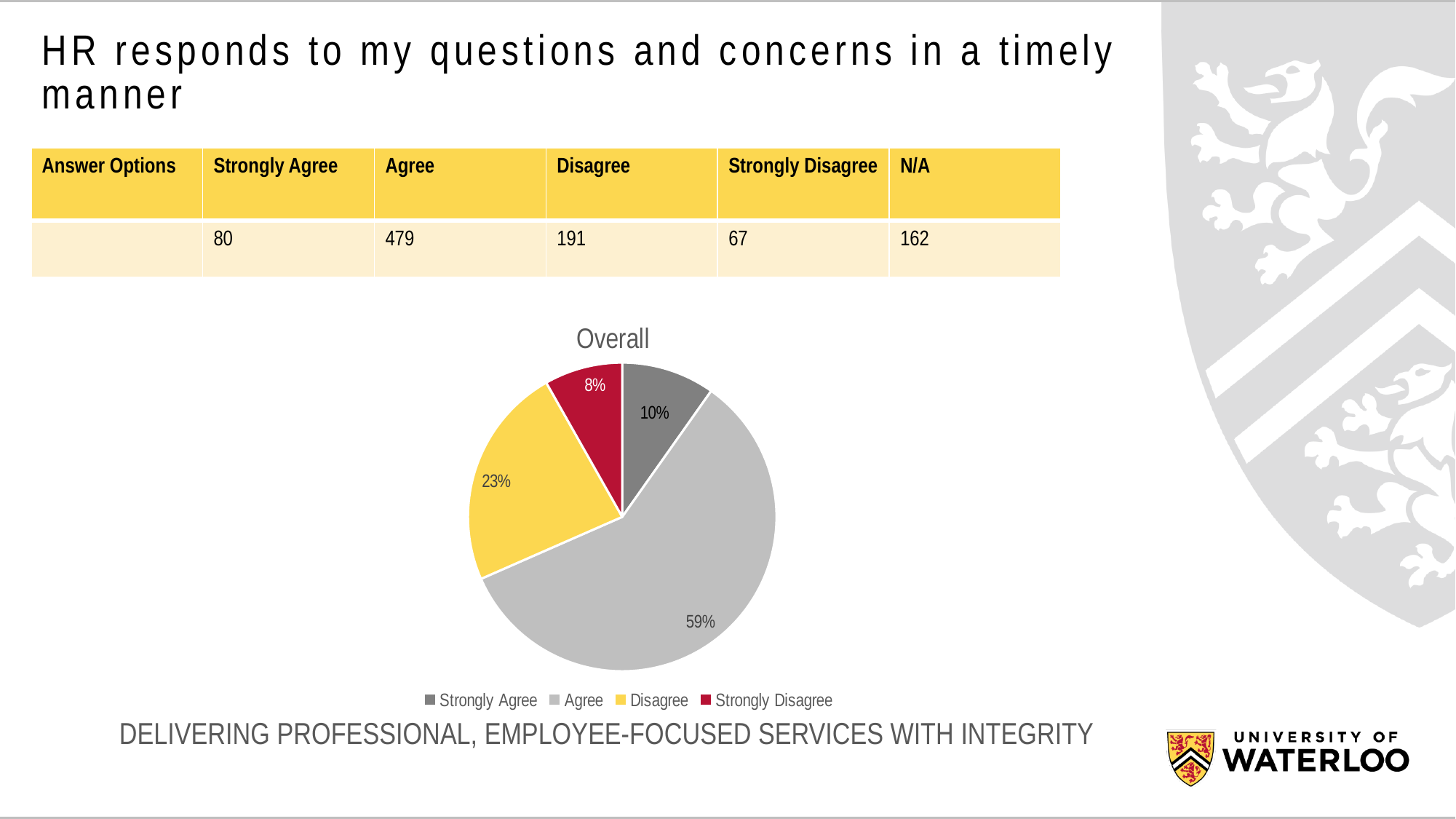
What colour is the Disagree slice in the pie chart? yellow How many categories does the pie chart legend list? 4 Which category has the largest slice of the pie? Agree What kind of chart is shown on the slide? pie chart What share of the pie does Strongly Agree represent? 10% What is the difference in percentage points between the Agree slice and the Disagree slice? 36 What share of the pie does Agree represent? 59% What share of the pie does Strongly Disagree represent? 8% Which category has the smallest slice of the pie? Strongly Disagree What is the title of the pie chart? Overall Which slice is larger, Strongly Agree or Disagree? Disagree